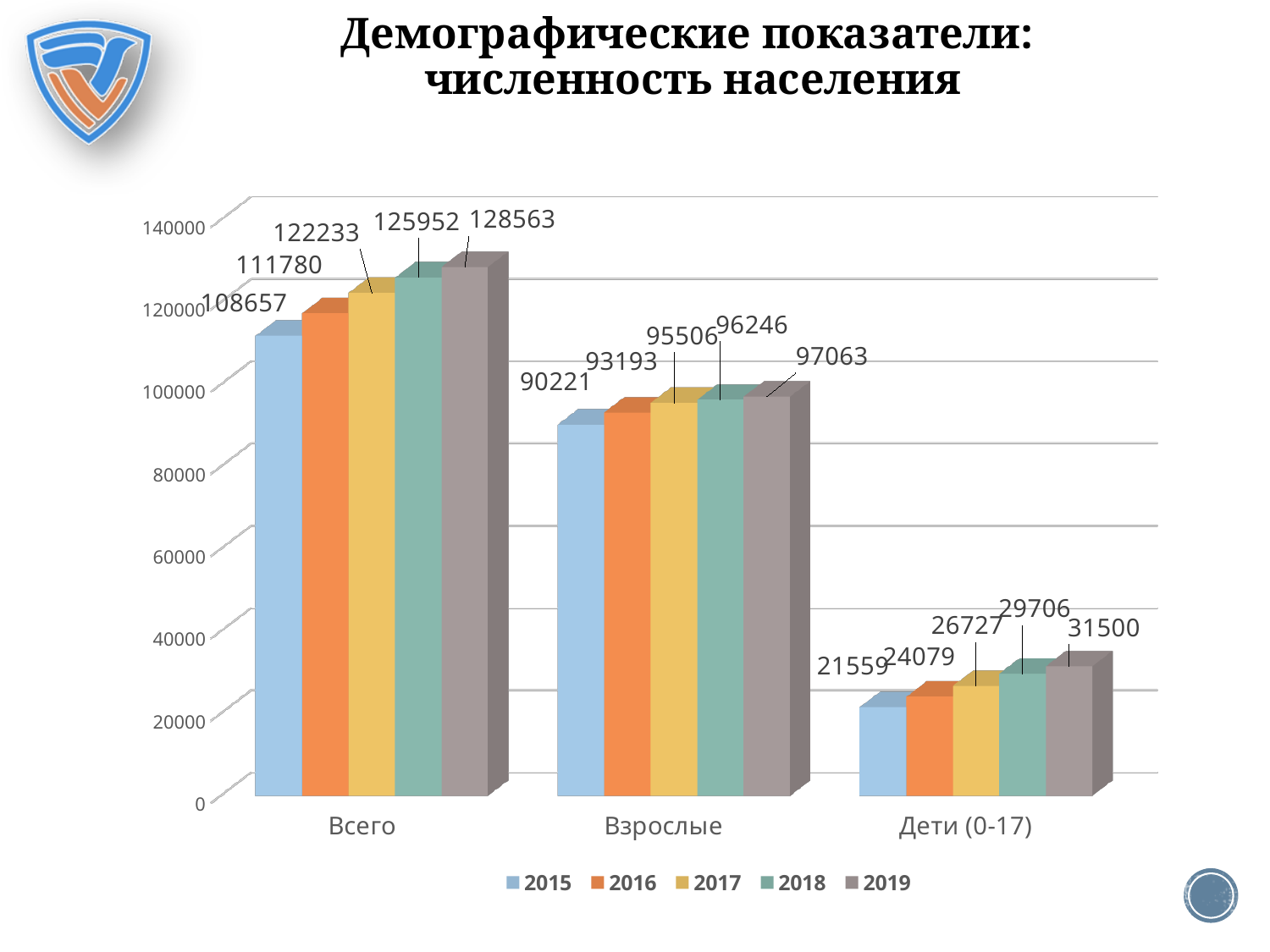
How many categories are shown on the x axis? 3 What is the difference between the 2019 and 2015 values for Всего? 16783 Do the values for Взрослые rise or fall from 2015 to 2019? Rise Which is larger: the 2016 value for Взрослые or the 2016 value for Дети (0-17)? Взрослые Which year has the highest value for Дети (0-17)? 2019 What is the value for Взрослые in 2015? 90221 Which year has the lowest value for Всего? 2015 What is the value for Дети (0-17) in 2017? 26727 What kind of chart is shown on the slide? Bar chart What is the value for Всего in 2019? 128563 How many series does the legend list? 5 What is the difference between the 2019 and 2018 values for Дети (0-17)? 1794